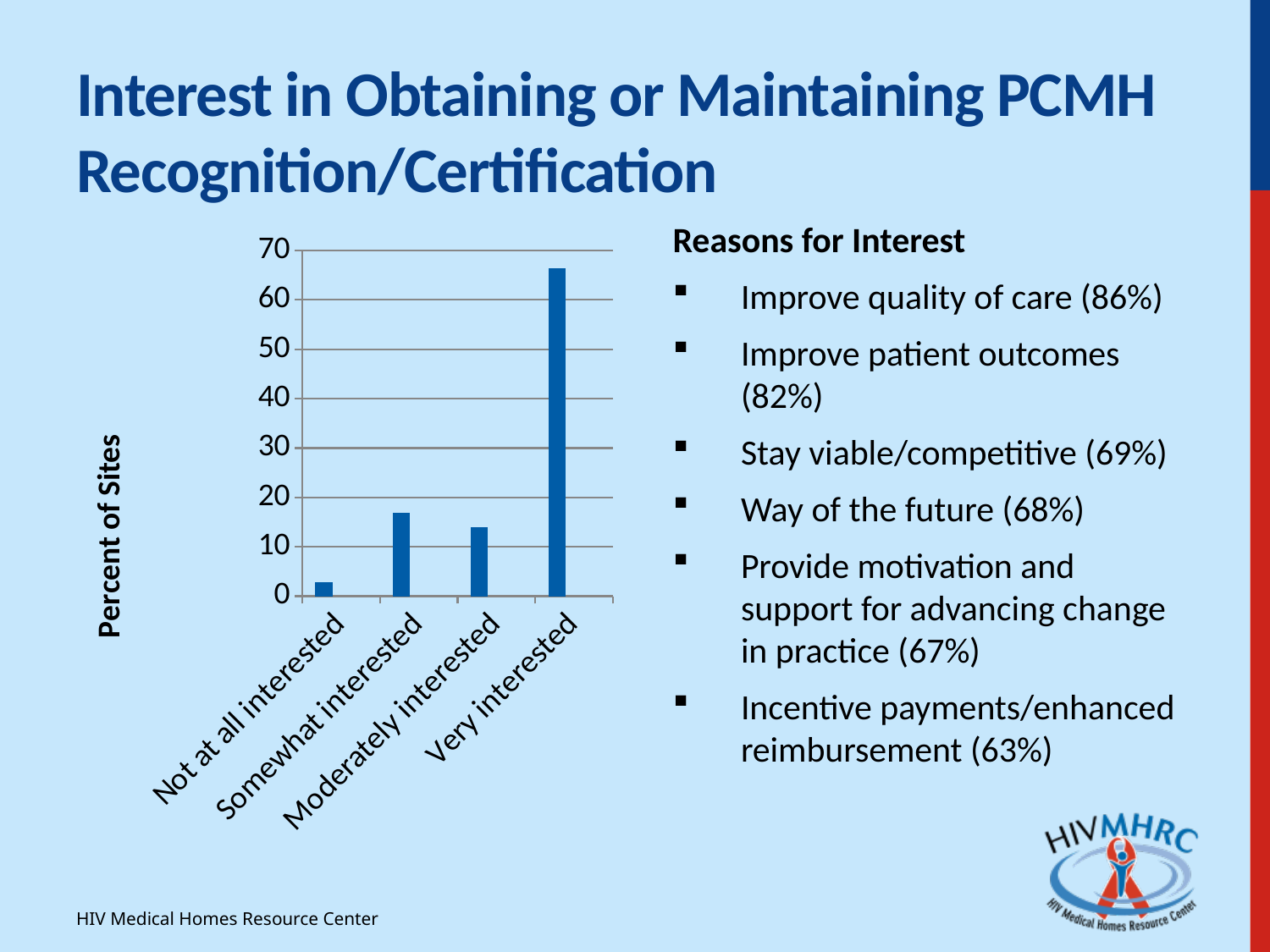
Is the value for Moderately interested greater or less than 10? greater What kind of chart is shown on the slide? bar chart How many categories are shown on the x axis of the chart? 4 Is the value for Very interested greater or less than 60? greater Which is larger, the value for Very interested or the value for Moderately interested? Very interested What is the highest value shown on the vertical axis of the chart? 70 Which category has the lowest percent of sites? Not at all interested Which is larger, the value for Somewhat interested or the value for Not at all interested? Somewhat interested Is the value for Not at all interested greater or less than 10? less What is the label on the vertical axis of the chart? Percent of Sites Which category has the highest percent of sites? Very interested